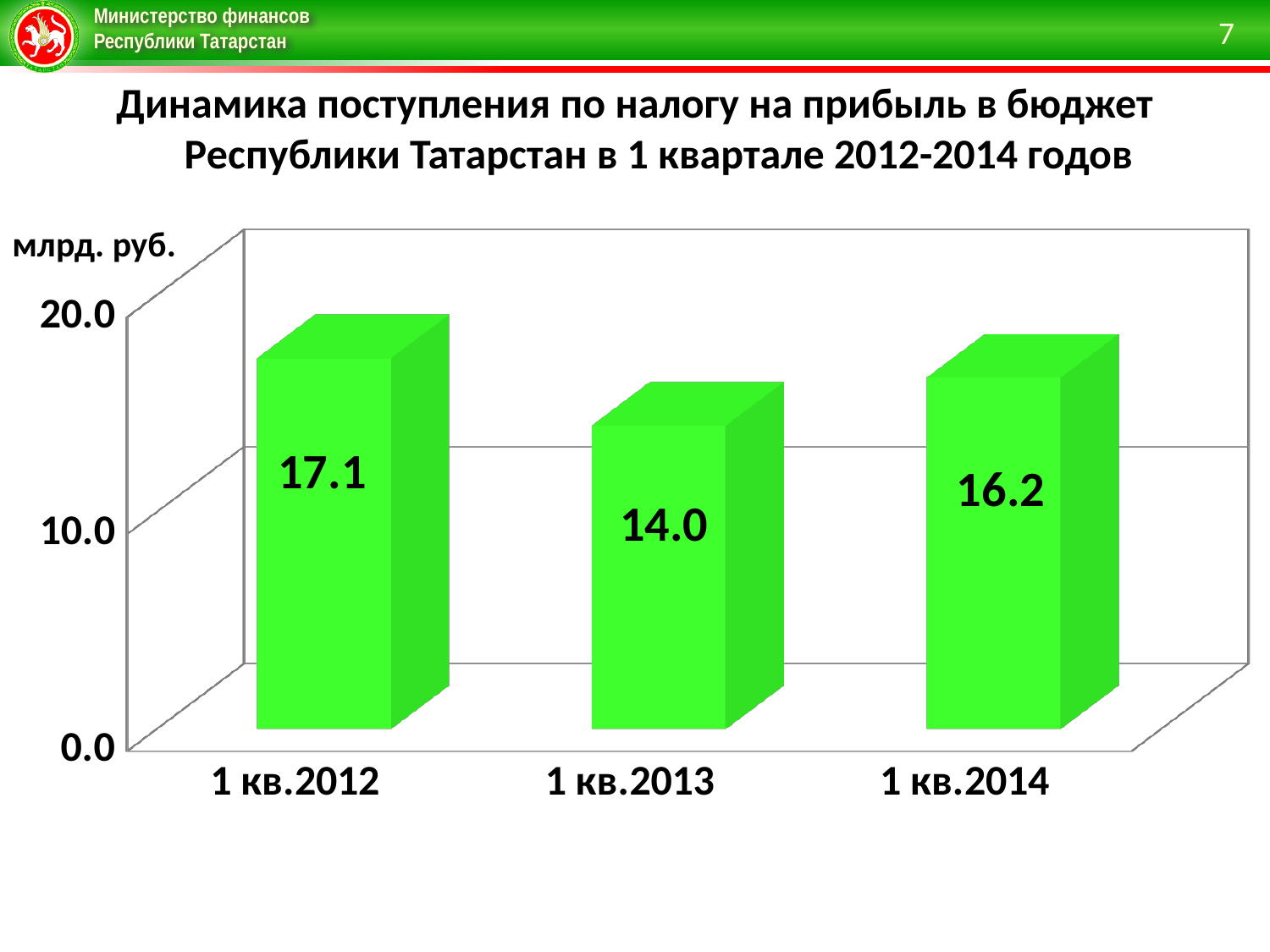
What is the value for 1 кв.2014? 16.2 Which period has the lowest value? 1 кв.2013 Which is larger, the value for 1 кв.2012 or the value for 1 кв.2014? 1 кв.2012 What unit of measurement is indicated on the chart? млрд. руб. Which period has the highest value? 1 кв.2012 What kind of chart is shown on the slide? bar chart What is the value for 1 кв.2012? 17.1 Is the value for 1 кв.2013 greater or less than 10.0? greater How many periods are shown on the chart? 3 What is the difference between the values for 1 кв.2014 and 1 кв.2013? 2.2 What is the difference between the values for 1 кв.2012 and 1 кв.2013? 3.1 What is the value for 1 кв.2013? 14.0